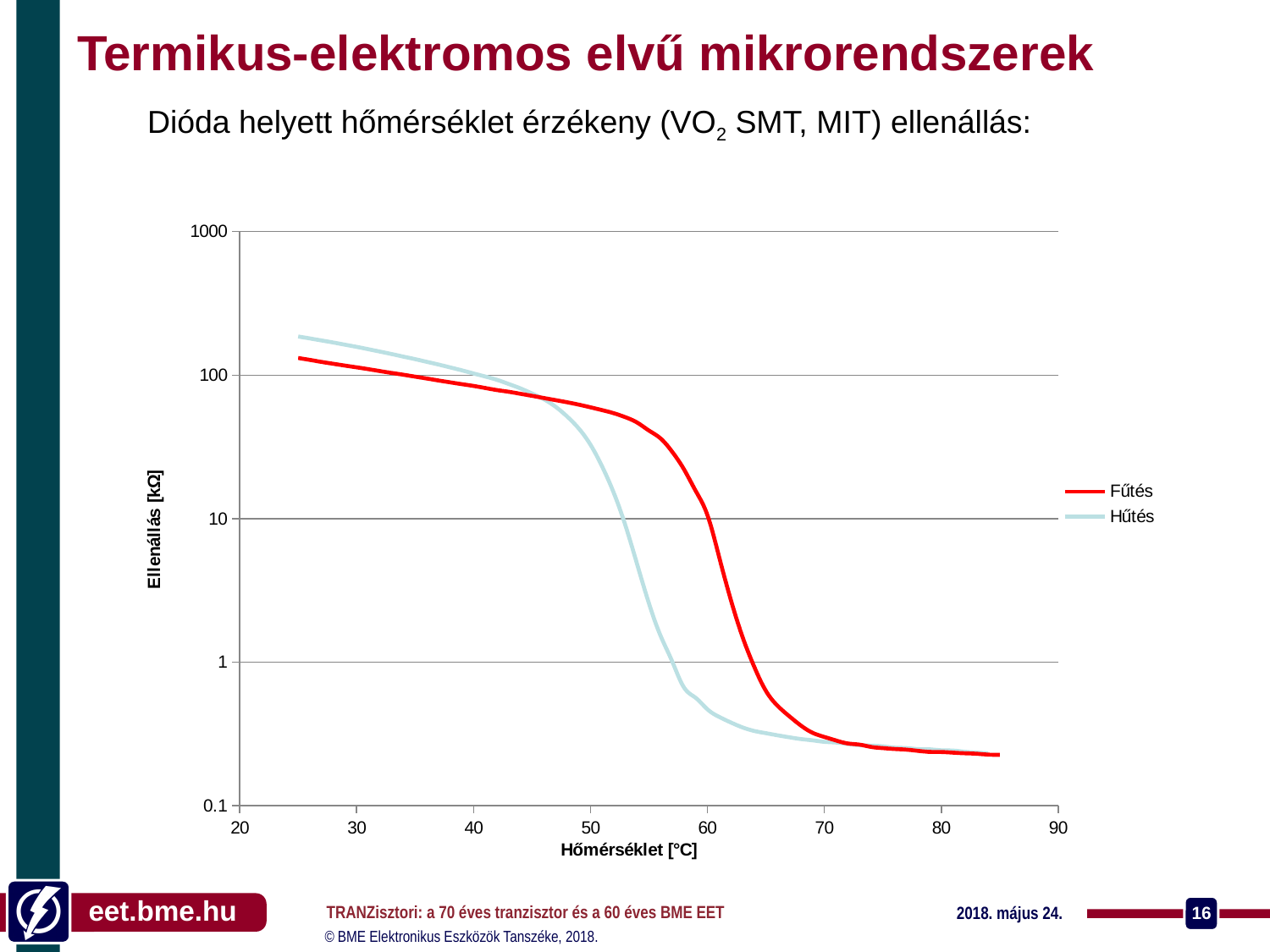
What is the label of the x axis of the chart? Hőmérséklet [°C] At 30 °C, which series has the larger value, Fűtés or Hűtés? Hűtés What are the two series named in the chart legend? Fűtés and Hűtés Is the value of the Hűtés series at 30 °C greater or less than 100? greater Do the values of the Hűtés series rise or fall as temperature increases along the x axis? fall Is the value of the Hűtés series at 55 °C greater or less than 10? less Is the value of the Fűtés series at 70 °C greater or less than 1? less At 55 °C, which series has the larger value, Fűtés or Hűtés? Fűtés Do the values of the Fűtés series rise or fall as temperature increases along the x axis? fall What kind of chart is shown on the slide? line chart How many series does the chart legend list? 2